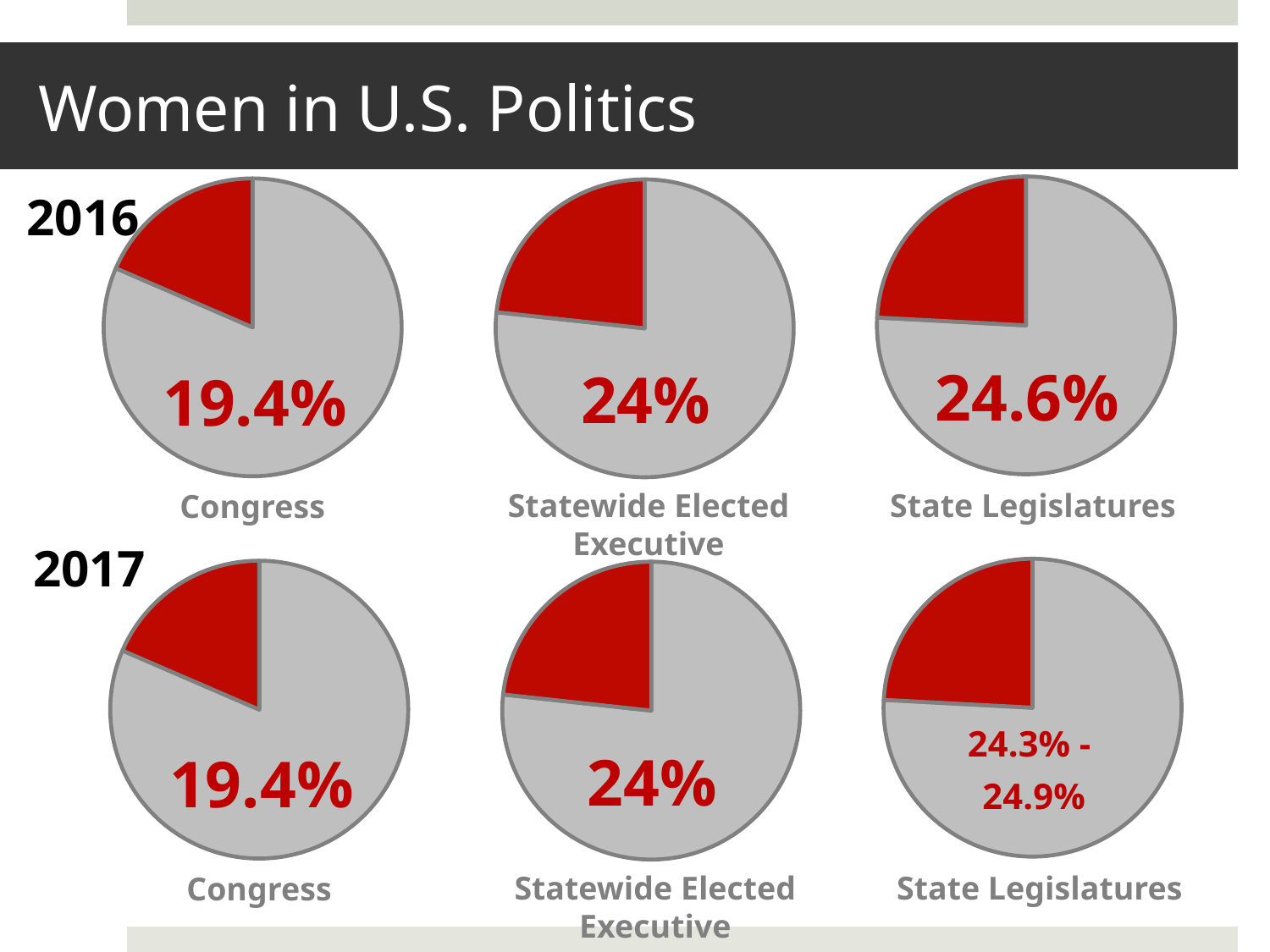
Among the three 2016 pie charts, which category has the lowest printed percentage? Congress In the 2016 State Legislatures pie chart, what percentage is printed? 24.6% Among the three 2016 pie charts, which category has the highest printed percentage? State Legislatures In the 2017 State Legislatures pie chart, what value is printed? 24.3% - 24.9% What is the difference between the 2016 State Legislatures percentage and the 2016 Congress percentage? 5.2% In the 2016 Statewide Elected Executive pie chart, what percentage is printed? 24% Which is larger: the 2016 Statewide Elected Executive percentage or the 2016 Congress percentage? Statewide Elected Executive What kind of chart is used for the Congress data on this slide? Pie chart How many pie charts are shown on the slide? 6 In the 2016 Congress pie chart, what share is shown for the red slice? 19.4% What is the title of the slide containing these charts? Women in U.S. Politics In the 2017 Congress pie chart, what percentage is printed? 19.4%